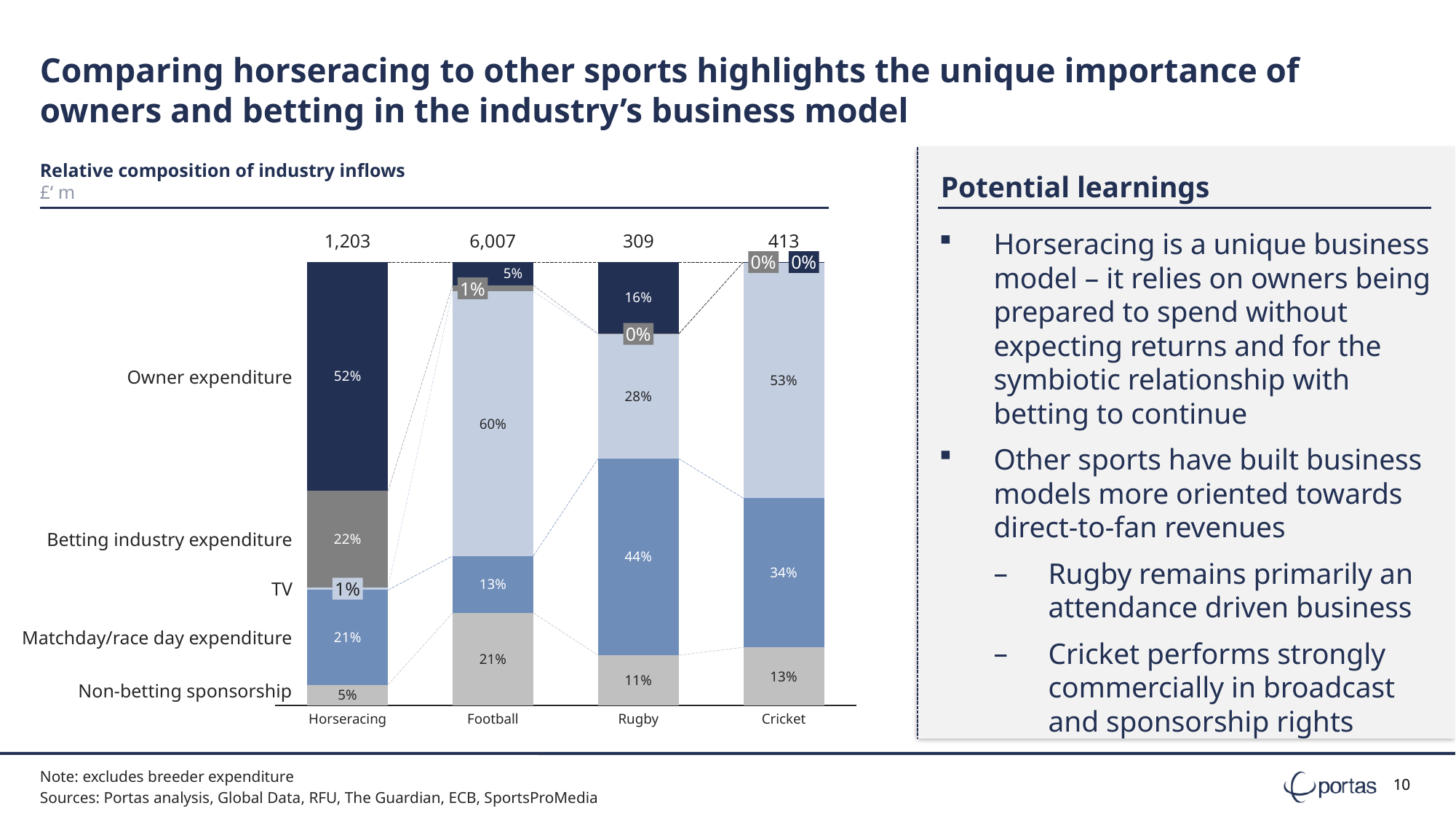
How many sports are compared in the chart? 4 What kind of chart is used to show the relative composition of industry inflows? Stacked bar chart Which sport has the highest share of Owner expenditure? Horseracing Which sport has the smallest total industry inflows shown above its bar? Rugby Which sport has the largest total industry inflows shown above its bar? Football What share of industry inflows does Matchday/race day expenditure represent for Rugby? 44% What share of industry inflows does TV represent for Football? 60% Is the Matchday/race day expenditure share larger for Rugby or for Cricket? Rugby What is the total industry inflow figure shown above the Football bar? 6,007 What share of industry inflows does Betting industry expenditure represent for Horseracing? 22% What share of industry inflows does Owner expenditure represent for Horseracing? 52% What is the difference in percentage points between the TV share for Football and the TV share for Horseracing? 59